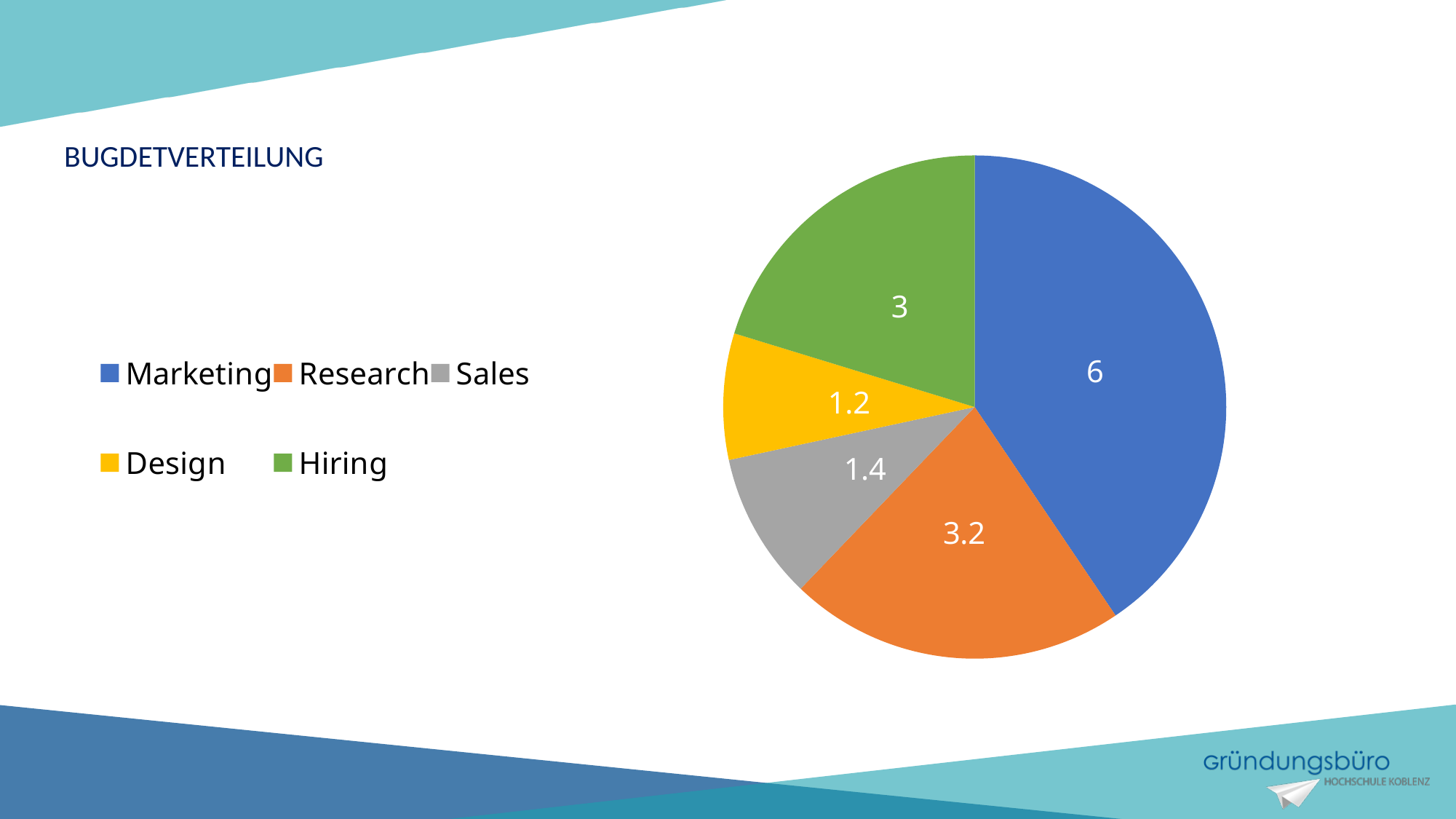
What is the value for Hiring in the pie chart? 3 What is the value for Research in the pie chart? 3.2 What is the difference between the values for Marketing and Research? 2.8 What is the title of the slide containing the chart? BUGDETVERTEILUNG What is the value for Sales in the pie chart? 1.4 What is the value for Design in the pie chart? 1.2 Which is larger, the value for Research or the value for Hiring? Research Which category has the largest slice of the pie chart? Marketing How many categories does the pie chart show? 5 What is the value for Marketing in the pie chart? 6 What kind of chart is shown on the slide? Pie chart Which category has the smallest slice of the pie chart? Design